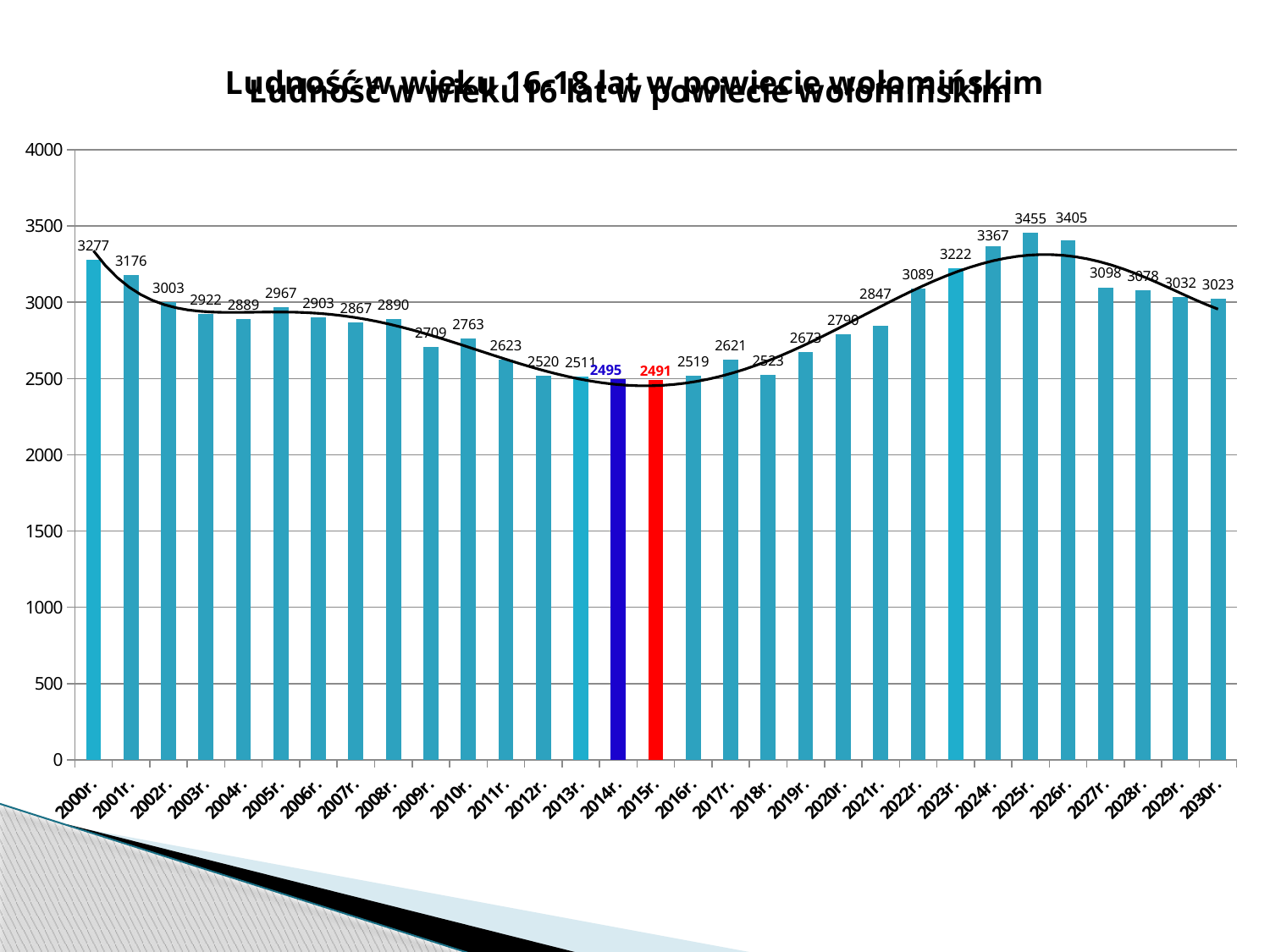
What kind of chart is shown on the slide? bar chart What is the value for 2009r.? 2709 How many years (bars) are shown on the chart? 31 Which year has the highest value? 2025r. What is the difference between the values for 2025r. and 2000r.? 178 What is the value for 2000r.? 3277 What is the value for 2025r.? 3455 Is the value for 2023r. greater or less than 3000? greater Which is larger, the value for 2014r. or the value for 2015r.? 2014r. Do the values rise or fall from 2000r. to 2014r.? fall Which year has the lowest value? 2015r. What is the value for 2015r.? 2491